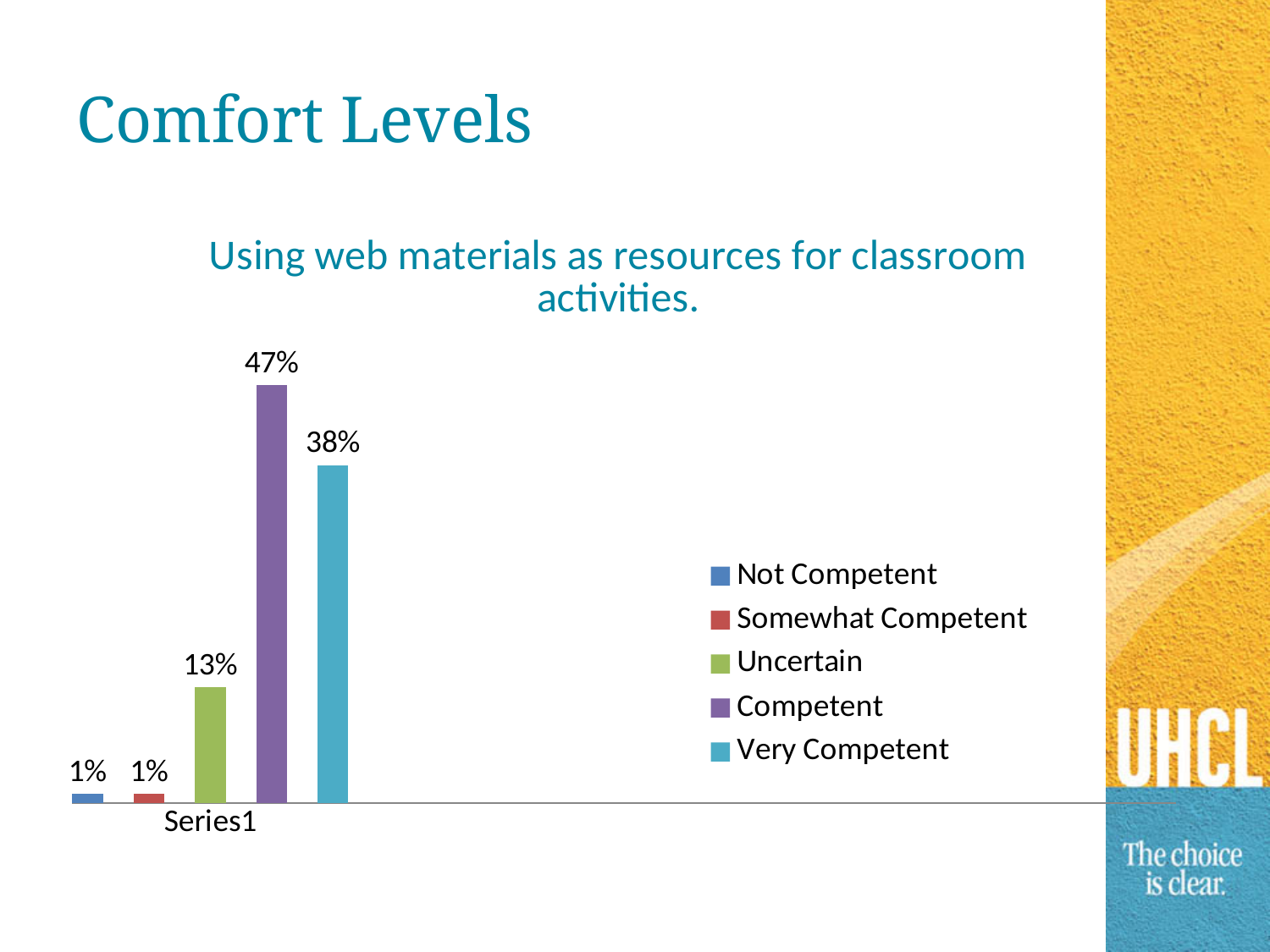
What is the difference between the Competent and Very Competent percentages? 9% What colour is the bar for Competent? Purple How many series does the legend list? 5 What kind of chart is shown on the slide? Bar chart What percentage of respondents rated themselves as Very Competent? 38% What percentage of respondents were Uncertain? 13% What percentage of respondents rated themselves as Not Competent? 1% Which is larger, the percentage for Uncertain or for Very Competent? Very Competent Which comfort level has the highest percentage? Competent What is the title of the chart? Using web materials as resources for classroom activities. What percentage of respondents rated themselves as Competent? 47% What is the difference between the Very Competent and Uncertain percentages? 25%